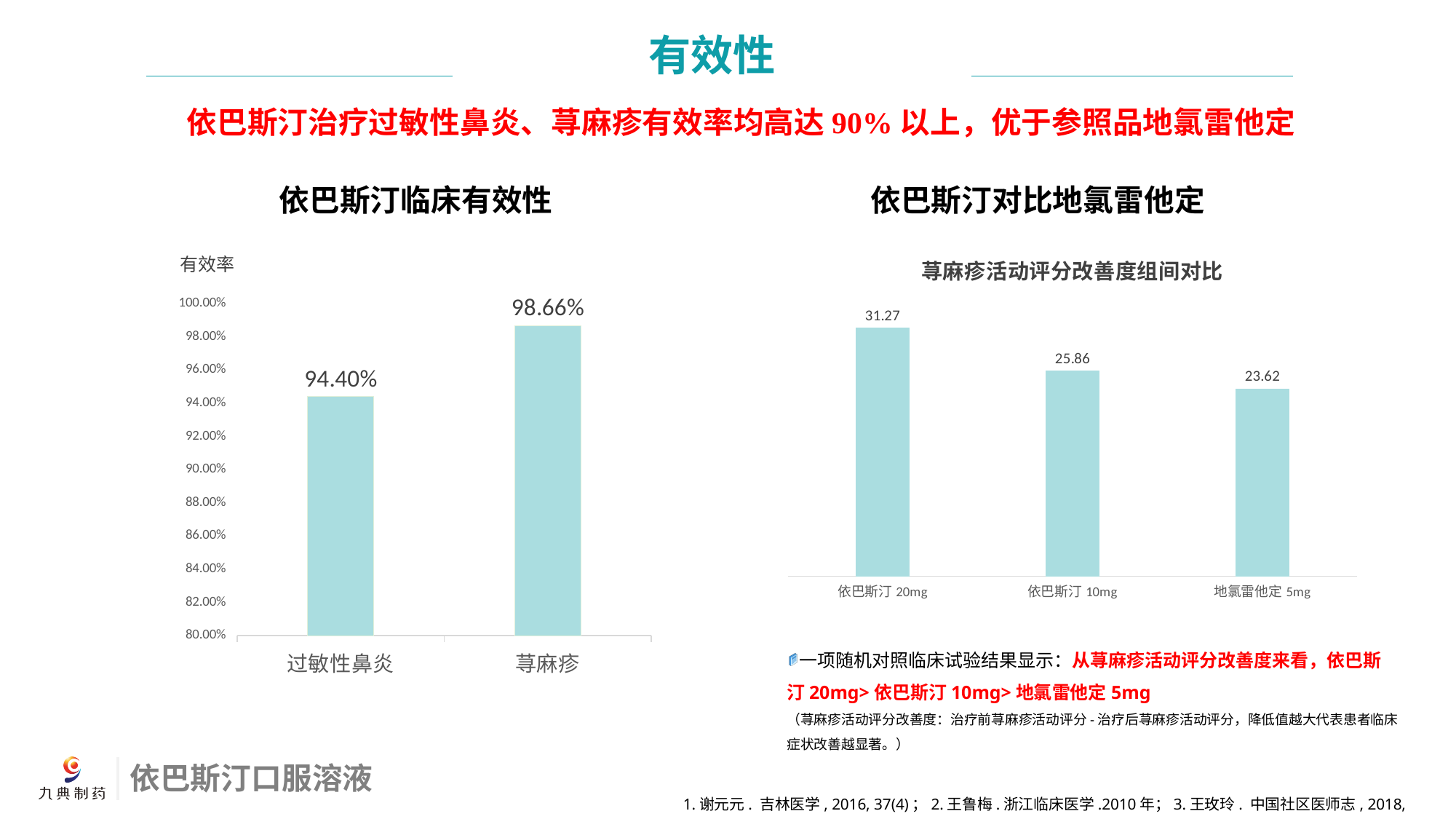
In the right chart (荨麻疹活动评分改善度组间对比), which category has the lowest value? 地氯雷他定 5mg In the left chart (依巴斯汀临床有效性), what is the difference between the values for 荨麻疹 and 过敏性鼻炎? 4.26% In the right chart (荨麻疹活动评分改善度组间对比), which is larger: 依巴斯汀 10mg or 地氯雷他定 5mg? 依巴斯汀 10mg What kind of chart is the left chart (依巴斯汀临床有效性)? Bar chart In the right chart (荨麻疹活动评分改善度组间对比), do the values rise or fall from left to right? Fall In the right chart (荨麻疹活动评分改善度组间对比), what is the difference between 依巴斯汀 20mg and 依巴斯汀 10mg? 5.41 In the right chart (荨麻疹活动评分改善度组间对比), what is the value for 地氯雷他定 5mg? 23.62 In the left chart (依巴斯汀临床有效性), which category has the higher value? 荨麻疹 In the left chart (依巴斯汀临床有效性), how many categories are shown? 2 In the right chart (荨麻疹活动评分改善度组间对比), what is the value for 依巴斯汀 20mg? 31.27 In the left chart (依巴斯汀临床有效性), what is the value for 过敏性鼻炎? 94.40% In the left chart (依巴斯汀临床有效性), what is the value for 荨麻疹? 98.66%